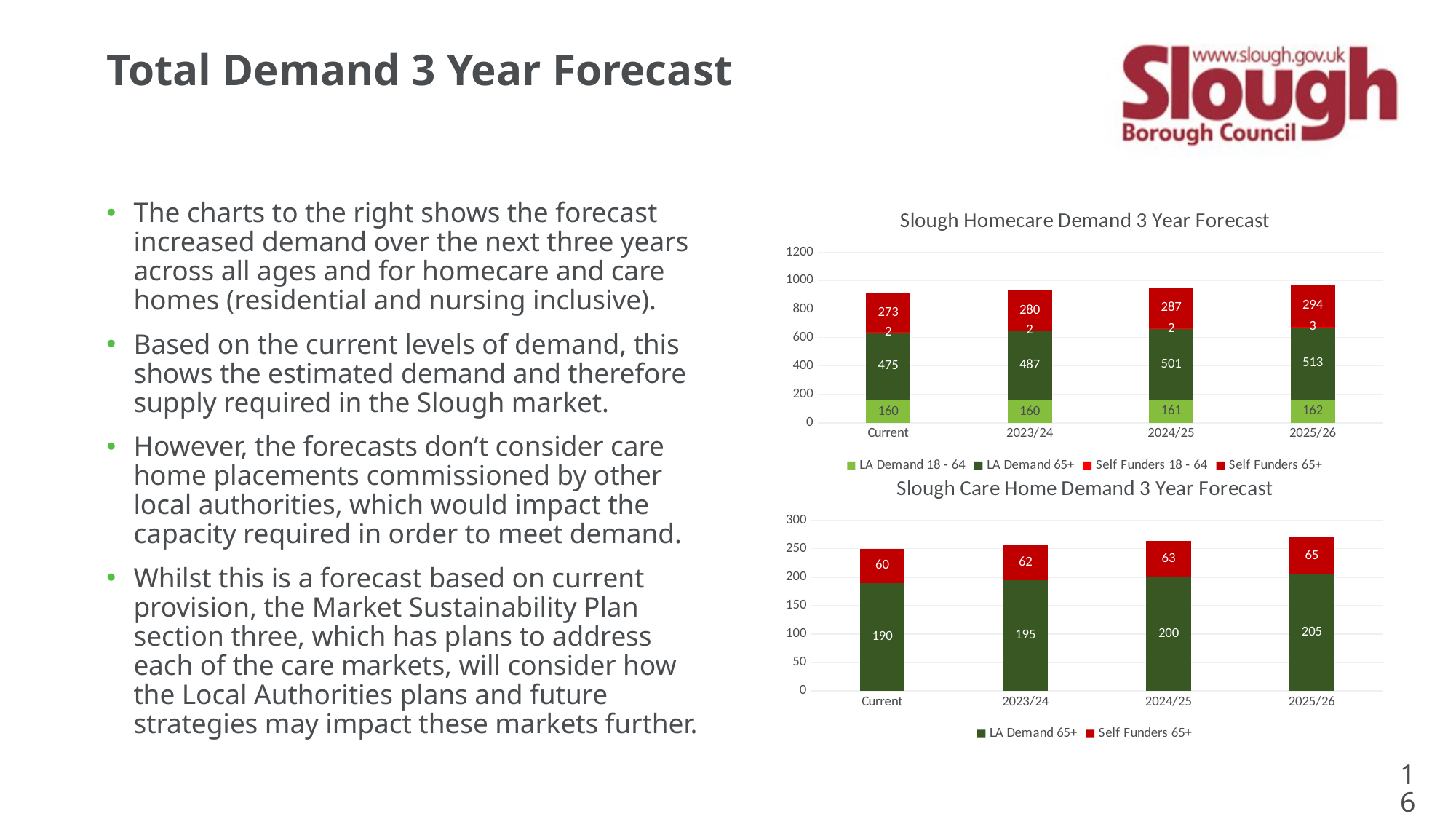
In the Slough Care Home Demand 3 Year Forecast chart, which period has the lowest Self Funders 65+ value? Current In the Slough Homecare Demand 3 Year Forecast chart, how many series does the legend list? 4 In the Slough Care Home Demand 3 Year Forecast chart, is the Self Funders 65+ value for 2024/25 larger or smaller than the LA Demand 65+ value for 2024/25? smaller In the Slough Homecare Demand 3 Year Forecast chart, what is the Self Funders 65+ value for 2025/26? 294 In the Slough Homecare Demand 3 Year Forecast chart, what is the total of the stacked bar for Current? 910 In the Slough Homecare Demand 3 Year Forecast chart, what is the difference between the LA Demand 65+ values for 2025/26 and Current? 38 What kind of chart is the Slough Care Home Demand 3 Year Forecast chart? stacked bar chart In the Slough Care Home Demand 3 Year Forecast chart, how many periods are shown on the x axis? 4 In the Slough Care Home Demand 3 Year Forecast chart, what is the LA Demand 65+ value for 2023/24? 195 In the Slough Homecare Demand 3 Year Forecast chart, does the LA Demand 65+ value rise or fall from Current to 2025/26? rise In the Slough Homecare Demand 3 Year Forecast chart, what is the LA Demand 65+ value for 2024/25? 501 In the Slough Care Home Demand 3 Year Forecast chart, what is the total of the stacked bar for 2025/26? 270